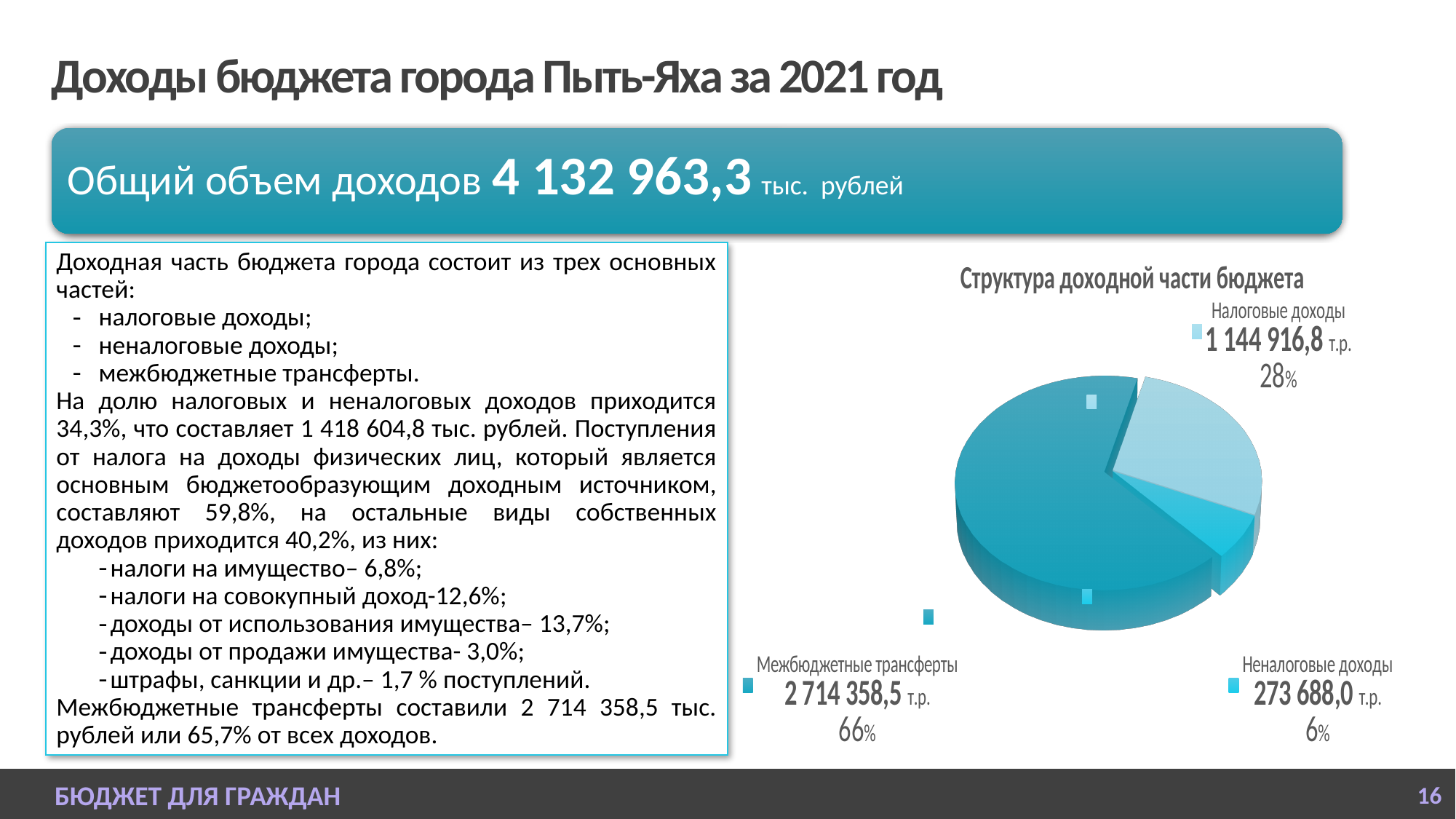
What is the title of the chart? Структура доходной части бюджета What share of the pie do Налоговые доходы represent? 28% What is the value shown for Неналоговые доходы? 273 688,0 т.р. What share of the pie do Межбюджетные трансферты represent? 66% Which is larger: Налоговые доходы or Неналоговые доходы? Налоговые доходы What is the difference between Межбюджетные трансферты and Налоговые доходы? 1 569 441,7 т.р. What is the value shown for Налоговые доходы? 1 144 916,8 т.р. What is the value shown for Межбюджетные трансферты? 2 714 358,5 т.р. Which category has the largest share of the pie? Межбюджетные трансферты How many slices does the pie chart have? 3 Which category has the smallest share of the pie? Неналоговые доходы What type of chart is shown on the slide? Pie chart